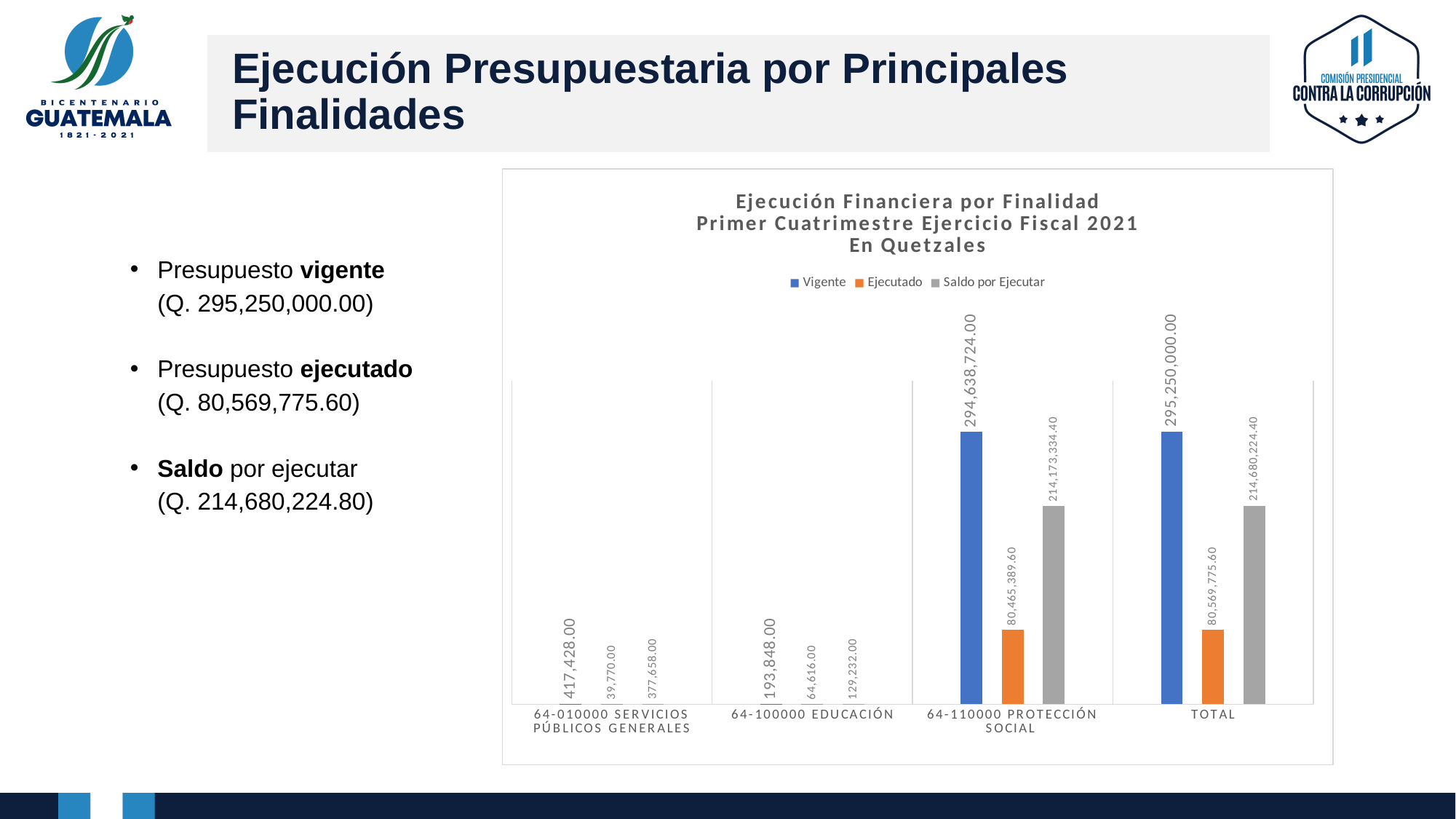
What is the Saldo por Ejecutar value for 64-010000 Servicios Públicos Generales? 377,658.00 What is the Ejecutado value for Total? 80,569,775.60 What is the difference between the Vigente and Ejecutado values for 64-010000 Servicios Públicos Generales? 377,658.00 Which is larger for 64-100000 Educación: the Ejecutado value or the Saldo por Ejecutar value? Saldo por Ejecutar What kind of chart is shown on the slide? Bar chart What is the difference between the Vigente and Ejecutado values for Total? 214,680,224.40 What is the Ejecutado value for 64-100000 Educación? 64,616.00 How many series does the legend list? 3 How many categories are shown on the x axis? 4 What is the Vigente value for 64-110000 Protección Social? 294,638,724.00 Excluding Total, which category has the highest Vigente value? 64-110000 Protección Social Which category has the lowest Ejecutado value? 64-010000 Servicios Públicos Generales